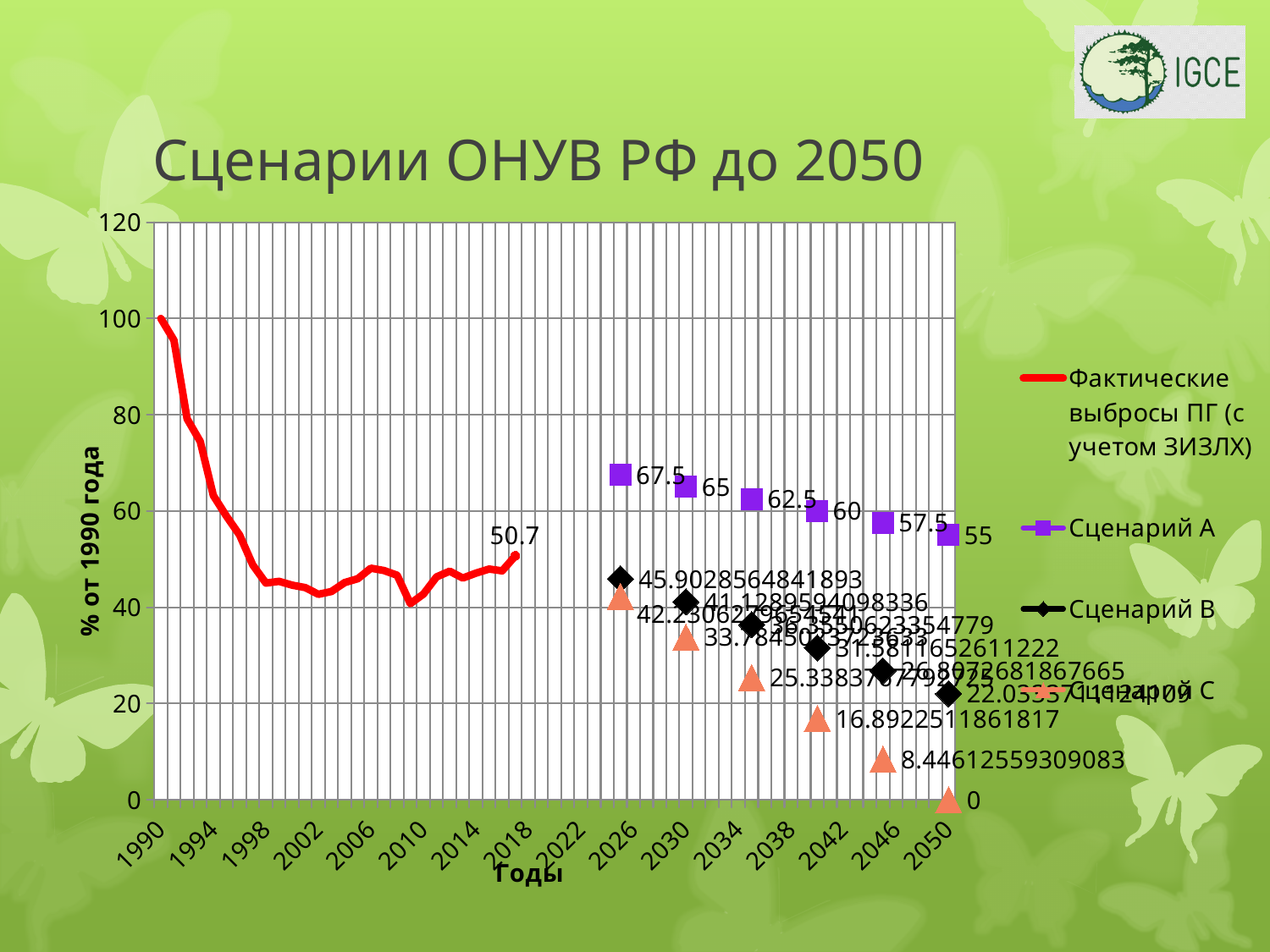
What is the last labelled value of the Фактические выбросы ПГ series? 50.7 What is the value of Сценарий A at 2050? 55 What is the difference between the first labelled value of Сценарий A (67.5) and its value at 2050 (55)? 12.5 What is the value of Сценарий C at 2050? 0 How many series does the legend list? 4 At 2050, which is larger: Сценарий A or Сценарий B? Сценарий A What is the labelled value of Сценарий C at 2045? 8.44612559309083 What is the title of the y axis? % от 1990 года Is the value of Фактические выбросы ПГ at 2010 greater or less than 60? less What is the first (highest) labelled value of Сценарий A? 67.5 What kind of chart is shown on the slide? line chart Do the values of Сценарий A rise or fall from 2025 to 2050? fall